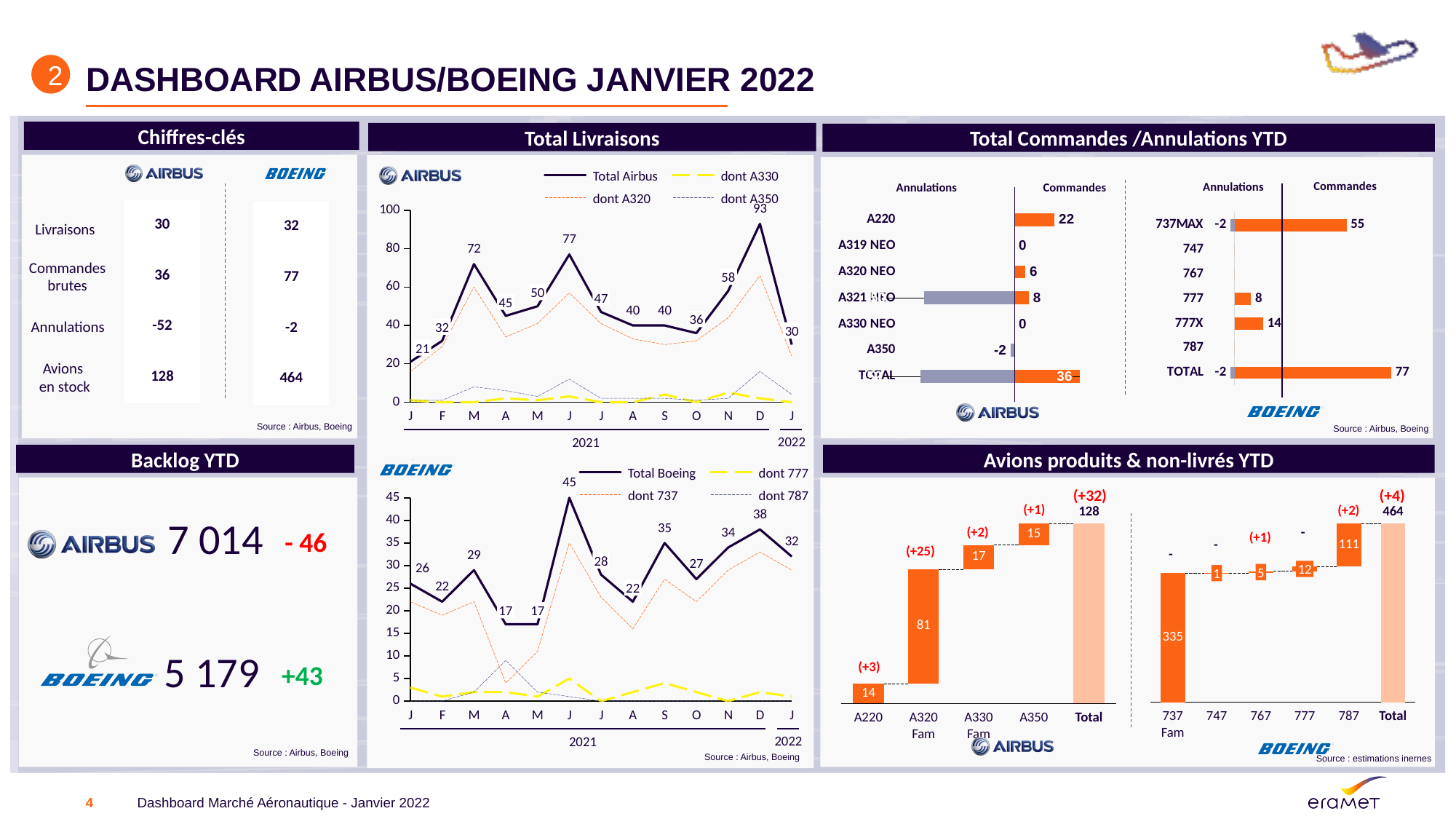
In the Boeing Total Livraisons line chart, which is larger: the Total Boeing value for September 2021 or November 2021? September 2021 In the Boeing Total Livraisons line chart, what was the Total Boeing value in June 2021? 45 In the Airbus Total Livraisons line chart, what was the Total Airbus value in December 2021? 93 In the Total Commandes / Annulations YTD chart for Boeing, how many Commandes are shown for the 737MAX? 55 In the Airbus Total Livraisons line chart, what is the difference between the Total Airbus values for March 2021 and April 2021? 27 In the Total Commandes / Annulations YTD chart for Boeing, what is the difference between the Commandes for the 777X and the 777? 6 In the Total Commandes / Annulations YTD chart for Airbus, how many Commandes are shown for the A220? 22 How many series does the legend of the Airbus Total Livraisons chart list? 4 In the Avions produits & non-livrés YTD chart, what is the Boeing Total? 464 In the Airbus Total Livraisons line chart, which month has the highest Total Airbus value? December 2021 In the Avions produits & non-livrés YTD chart, what is the value for the A320 Fam? 81 In the Boeing Total Livraisons line chart, what is the lowest Total Boeing value shown? 17